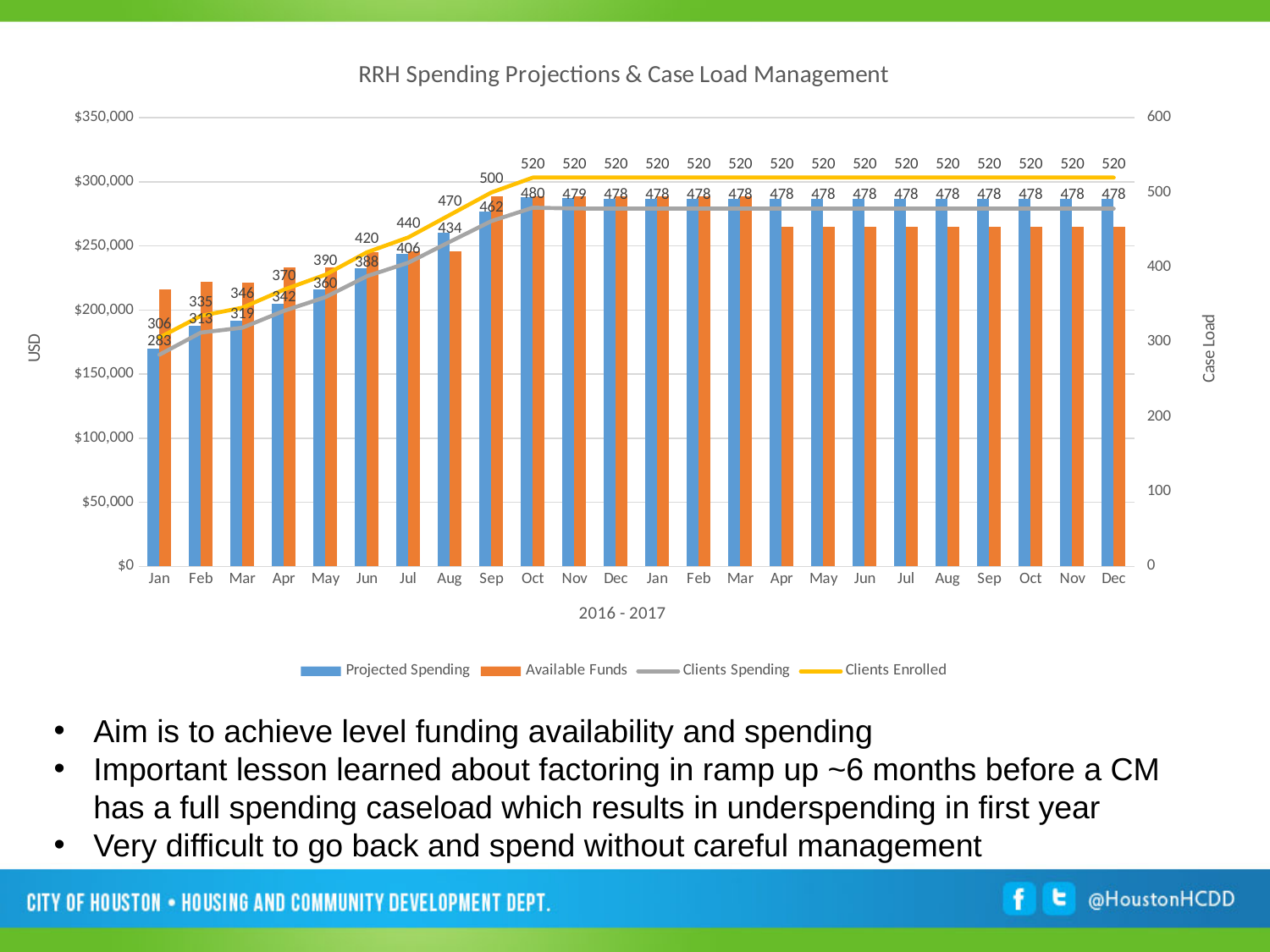
What is the Clients Spending value for the first Jan on the x axis? 283 How many months are shown along the x axis? 24 What is the Clients Spending value for the first Oct on the x axis? 480 What is the difference between Clients Enrolled and Clients Spending for the first Jan on the x axis? 23 What is the Clients Enrolled value for the first Sep on the x axis? 500 What is the Clients Enrolled value for the first Jan on the x axis? 306 What is the title of the right-hand vertical axis? Case Load What kind of chart is shown on the slide? A combination bar and line chart What is the highest value reached by the Clients Enrolled line? 520 How many series does the legend list? 4 How does the Clients Enrolled line change from the first Jan to the first Oct on the x axis? It rises Is the Projected Spending bar for the first Jan on the x axis greater or less than $200,000? less